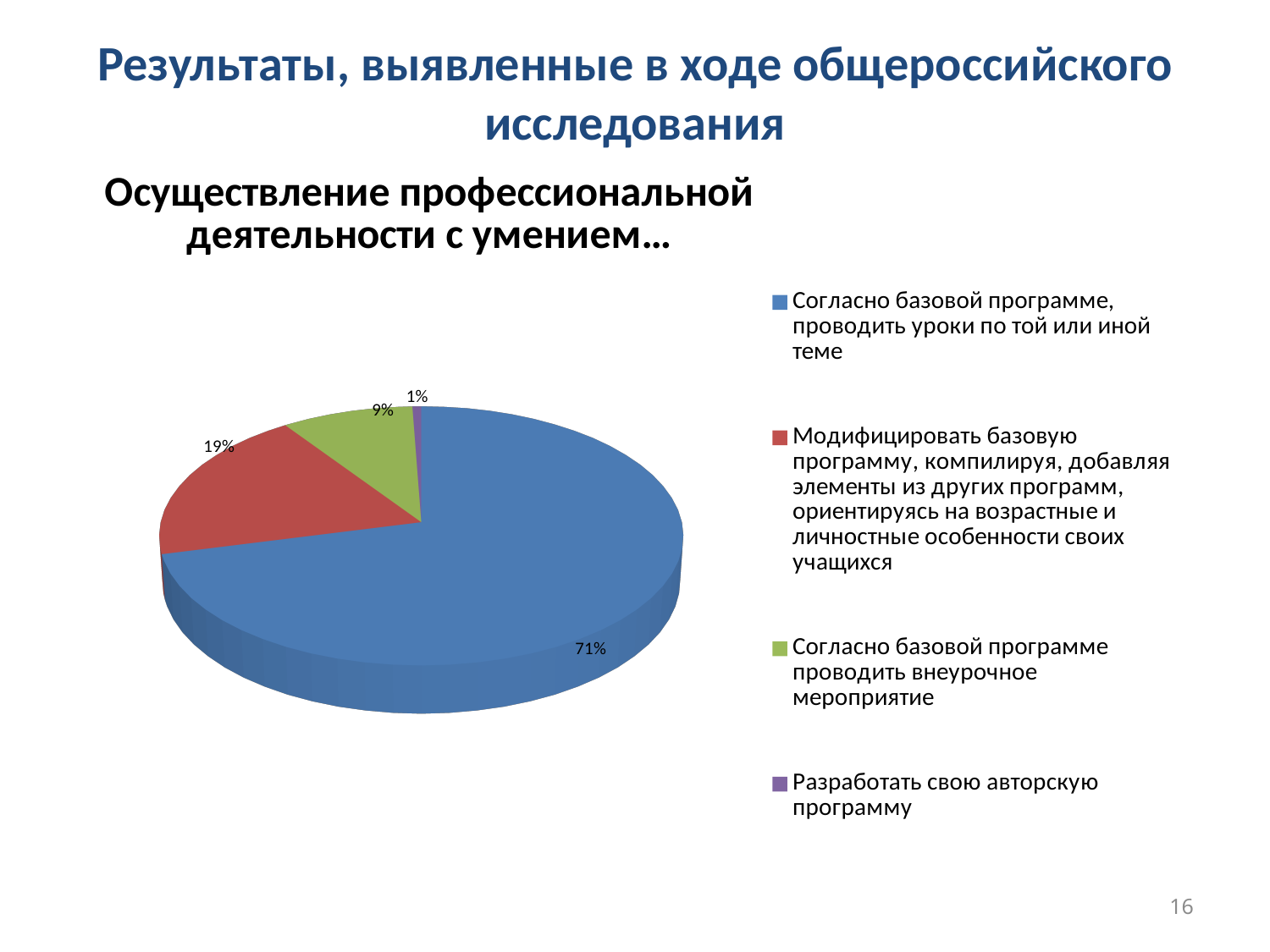
What is the title of the chart? Осуществление профессиональной деятельности с умением… How many slices does the pie chart have? 4 Which is larger: the slice for 'Согласно базовой программе проводить внеурочное мероприятие' or the slice for 'Разработать свою авторскую программу'? Согласно базовой программе проводить внеурочное мероприятие What colour is the slice for 'Модифицировать базовую программу, компилируя, добавляя элементы из других программ, ориентируясь на возрастные и личностные особенности своих учащихся'? Red What is the difference in percentage points between the 71% slice and the 19% slice? 52 What share of the pie is labelled for 'Модифицировать базовую программу, компилируя, добавляя элементы из других программ, ориентируясь на возрастные и личностные особенности своих учащихся'? 19% What share of the pie is labelled for 'Согласно базовой программе, проводить уроки по той или иной теме'? 71% What kind of chart is shown on the slide? Pie chart Which category has the smallest slice of the pie? Разработать свою авторскую программу Which category has the largest slice of the pie? Согласно базовой программе, проводить уроки по той или иной теме What share of the pie is labelled for 'Согласно базовой программе проводить внеурочное мероприятие'? 9% What share of the pie is labelled for 'Разработать свою авторскую программу'? 1%